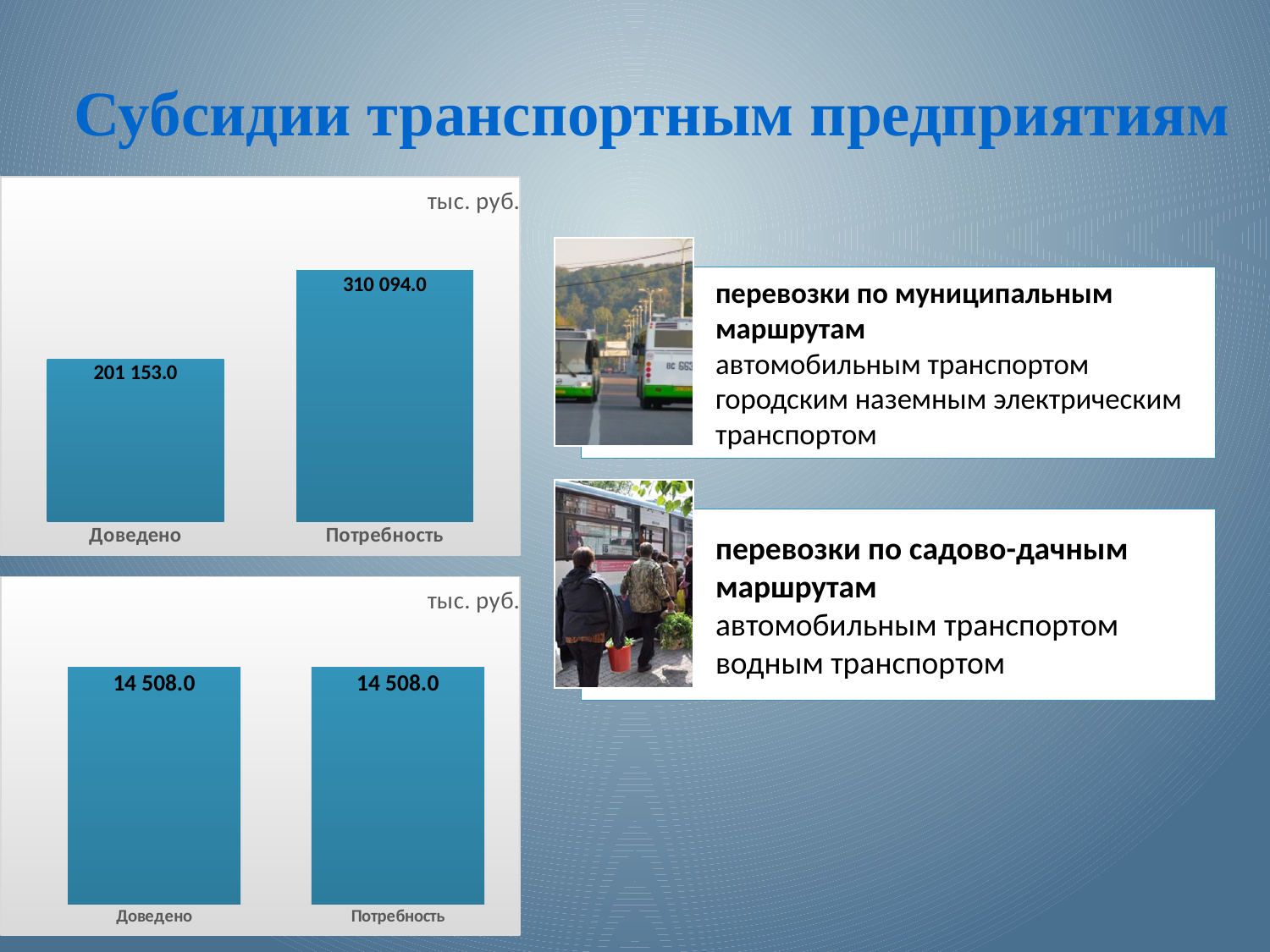
What unit is shown above the top chart? тыс. руб. In the top chart, which category has the lower value? Доведено In the top chart, is the value for Доведено larger or smaller than the value for Потребность? smaller In the bottom chart, are the values for Доведено and Потребность equal? Yes In the top chart, which category has the higher value? Потребность In the top chart, what is the difference between Потребность and Доведено? 108 941.0 In the top chart, what is the value for Доведено? 201 153.0 How many categories does the top chart show? 2 In the top chart, what is the value for Потребность? 310 094.0 In the bottom chart, what is the value for Потребность? 14 508.0 What type of chart is the bottom chart? Bar chart In the bottom chart, what is the value for Доведено? 14 508.0